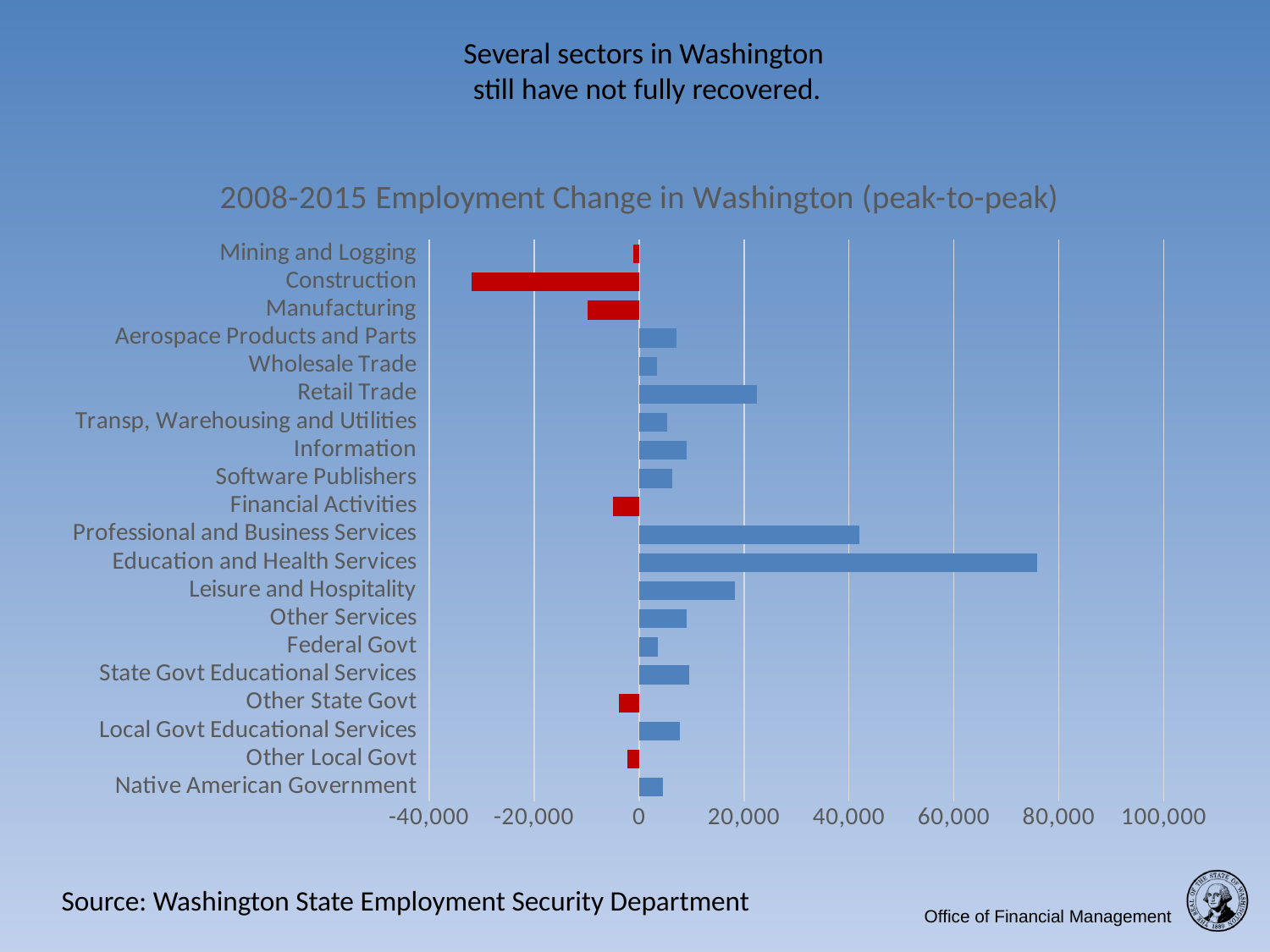
Which is larger, the value for Professional and Business Services or the value for Retail Trade? Professional and Business Services How many sectors show a negative (red) employment change in the chart? 6 Which is larger, the value for Leisure and Hospitality or the value for Federal Govt? Leisure and Hospitality Is the value for Education and Health Services greater or less than 60,000? greater What kind of chart is shown on the slide? Bar chart Which sector has the lowest (most negative) employment change in the chart? Construction How many sectors are plotted in the chart? 20 Is the value for Construction greater or less than -20,000? less What is the title of the chart? 2008-2015 Employment Change in Washington (peak-to-peak) Is the value for Professional and Business Services greater or less than 60,000? less Which sector has the largest employment change in the chart? Education and Health Services